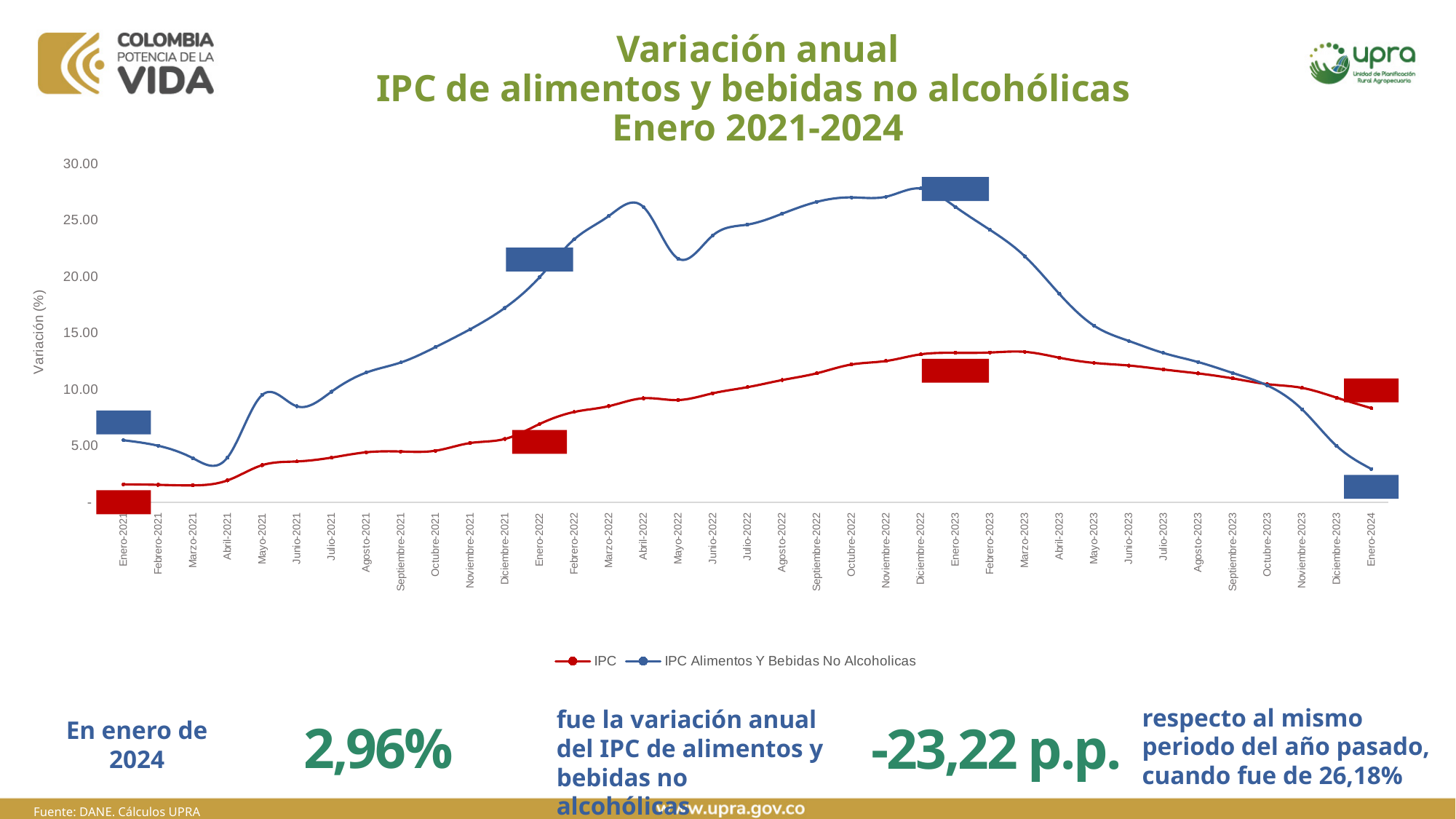
What kind of chart is shown on the slide? line chart According to the slide, what was the annual variation of the IPC de alimentos y bebidas no alcohólicas in Enero-2024? 2,96% What is the label of the y axis? Variación (%) Does the IPC Alimentos Y Bebidas No Alcoholicas series rise or fall between Diciembre-2022 and Enero-2024? fall According to the slide, what was the annual variation of the IPC de alimentos y bebidas no alcohólicas in the same period of the previous year (Enero-2023)? 26,18% Is the value of the IPC series in Marzo-2023 greater or less than 10.00? greater How many series does the chart legend list? 2 Is the value of the IPC series in Enero-2021 greater or less than 5.00? less Is the value of the IPC Alimentos Y Bebidas No Alcoholicas series in Diciembre-2022 greater or less than 25.00? greater In Enero-2024, which series has the higher value, IPC or IPC Alimentos Y Bebidas No Alcoholicas? IPC In which month does the IPC Alimentos Y Bebidas No Alcoholicas series reach its highest value? Diciembre-2022 How many monthly points are plotted along the x axis, from Enero-2021 to Enero-2024? 37